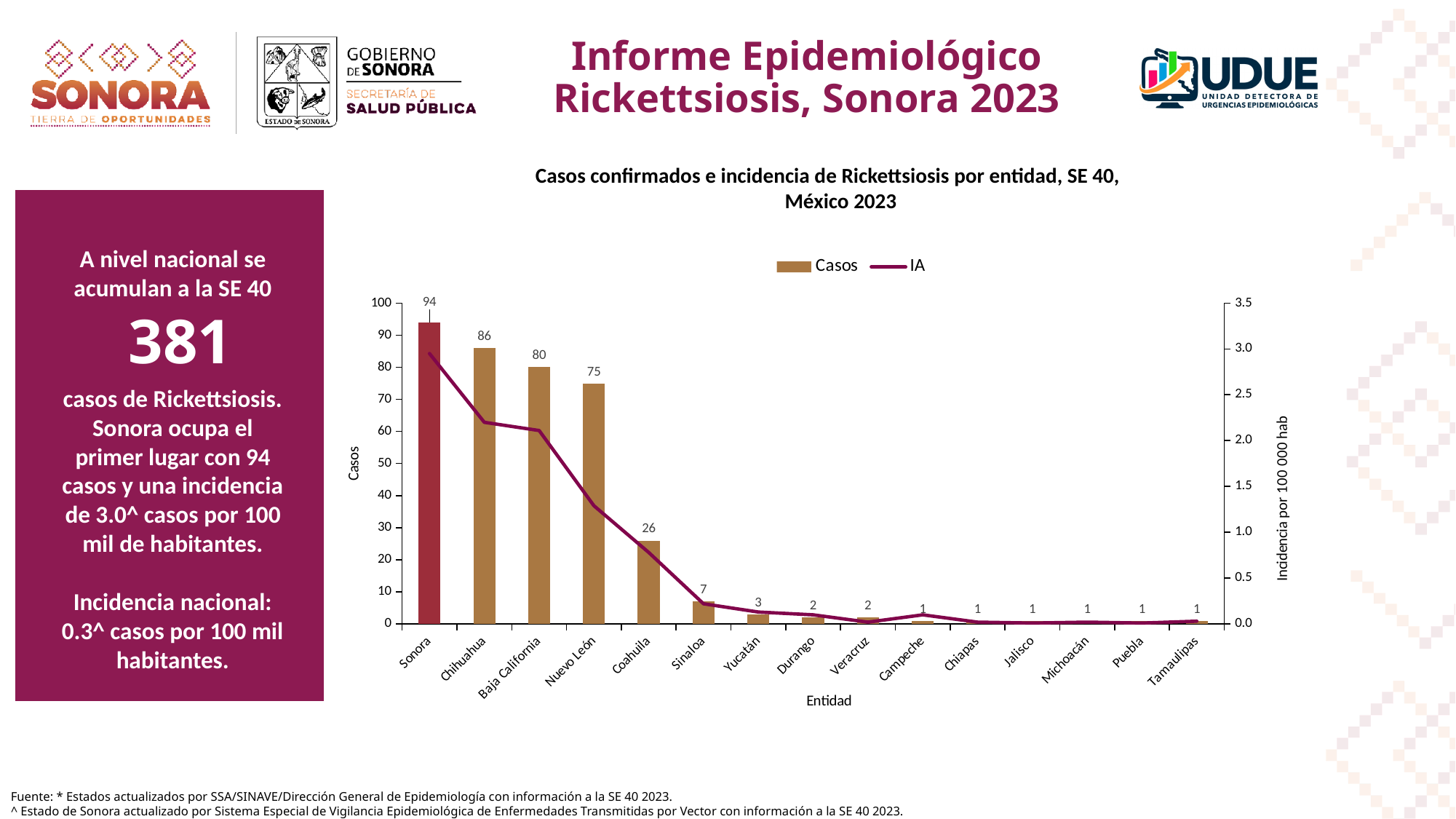
What is the difference in cases between Baja California and Coahuila? 54 Is the IA (incidence) value for Sonora greater or less than 2.5? greater How many confirmed cases does the chart show for Sonora? 94 What is the difference in cases between Sonora and Chihuahua? 8 What is the label of the right-hand vertical axis? Incidencia por 100 000 hab Which has more cases, Chihuahua or Baja California? Chihuahua Is the IA (incidence) value for Coahuila greater or less than 1.5? less How many series does the chart legend list? 2 Which entity has the highest number of cases in the chart? Sonora How many cases are shown for Coahuila? 26 How many entities are shown on the x axis of the chart? 15 What is the number of cases shown for Nuevo León? 75